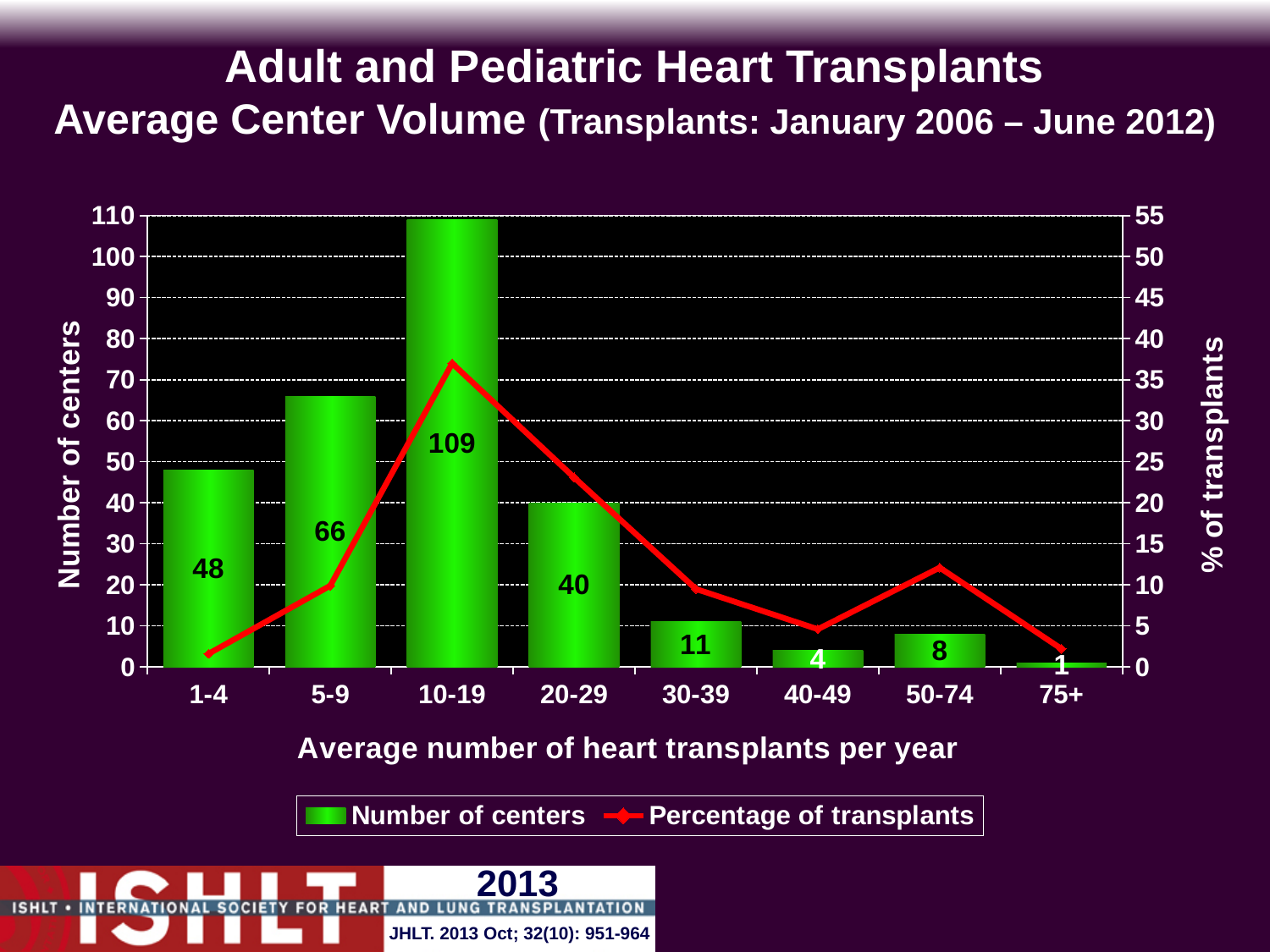
What is the number of centers for the 5-9 category? 66 Which category has the highest number of centers? 10-19 Is the percentage of transplants for the 50-74 category greater or less than 10? greater What kind of chart is shown on the slide? bar chart with a line overlay How many categories of average number of heart transplants per year are shown on the x axis? 8 Which category has the lowest number of centers? 75+ What is the number of centers for the 75+ category? 1 What is the difference in number of centers between the 10-19 and 5-9 categories? 43 How many series does the legend list? 2 How many centers are in the 10-19 average transplants per year category? 109 Which has more centers, the 1-4 category or the 20-29 category? 1-4 Is the percentage of transplants for the 10-19 category greater or less than 30? greater